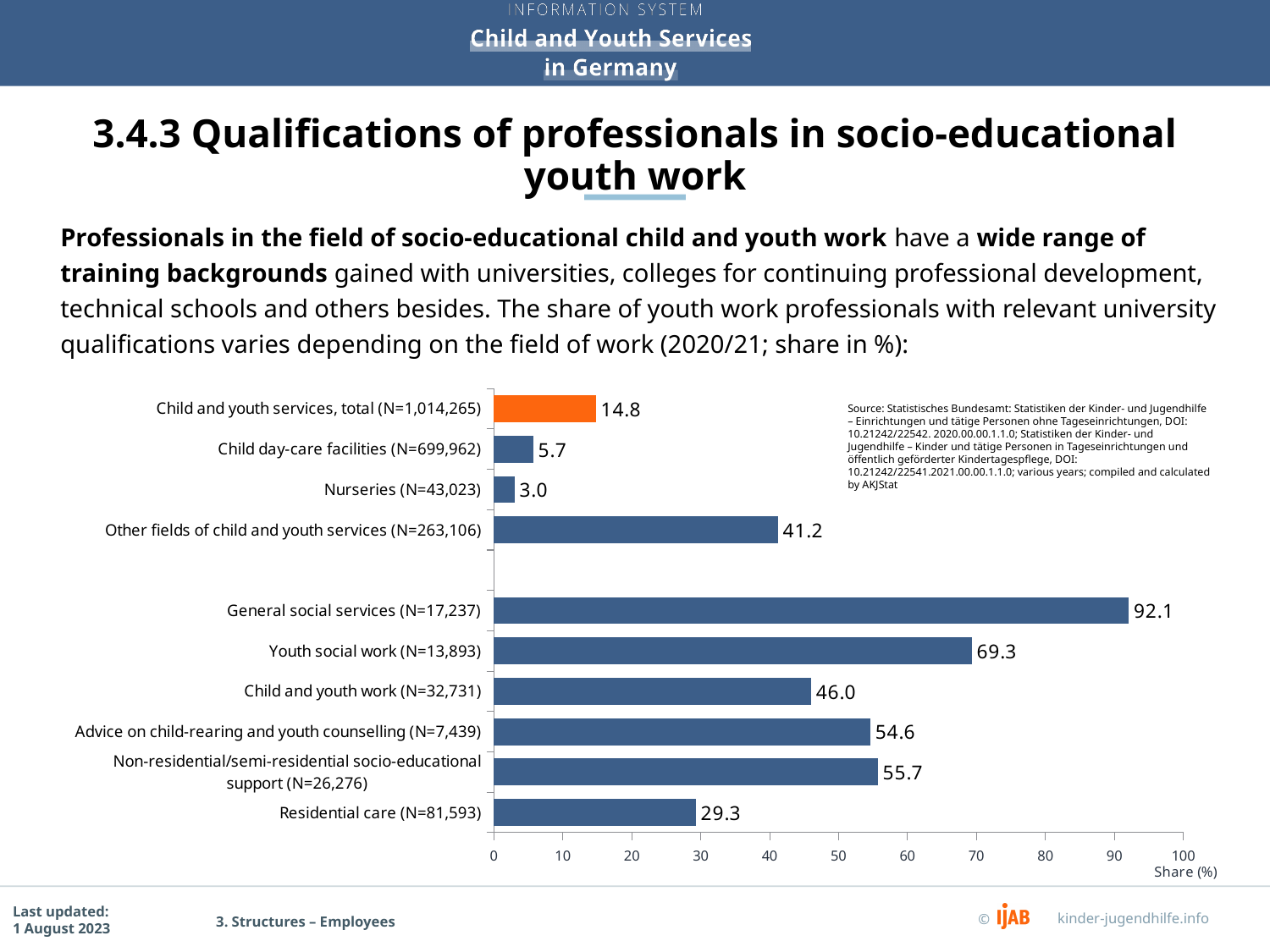
Is the value for Non-residential/semi-residential socio-educational support (N=26,276) greater or less than 50? greater What is the value for Child and youth services, total (N=1,014,265)? 14.8 Which category has the lowest value? Nurseries (N=43,023) What is the value for Residential care (N=81,593)? 29.3 What is the value for General social services (N=17,237)? 92.1 What is the difference between the values for Youth social work (N=13,893) and Child and youth work (N=32,731)? 23.3 How many categories are plotted in the chart? 10 What kind of chart is shown on the slide? bar chart Which is larger: the value for Advice on child-rearing and youth counselling (N=7,439) or the value for Other fields of child and youth services (N=263,106)? Advice on child-rearing and youth counselling (N=7,439) Which category has the highest value? General social services (N=17,237) What is the label of the x axis? Share (%) What is the value for Nurseries (N=43,023)? 3.0